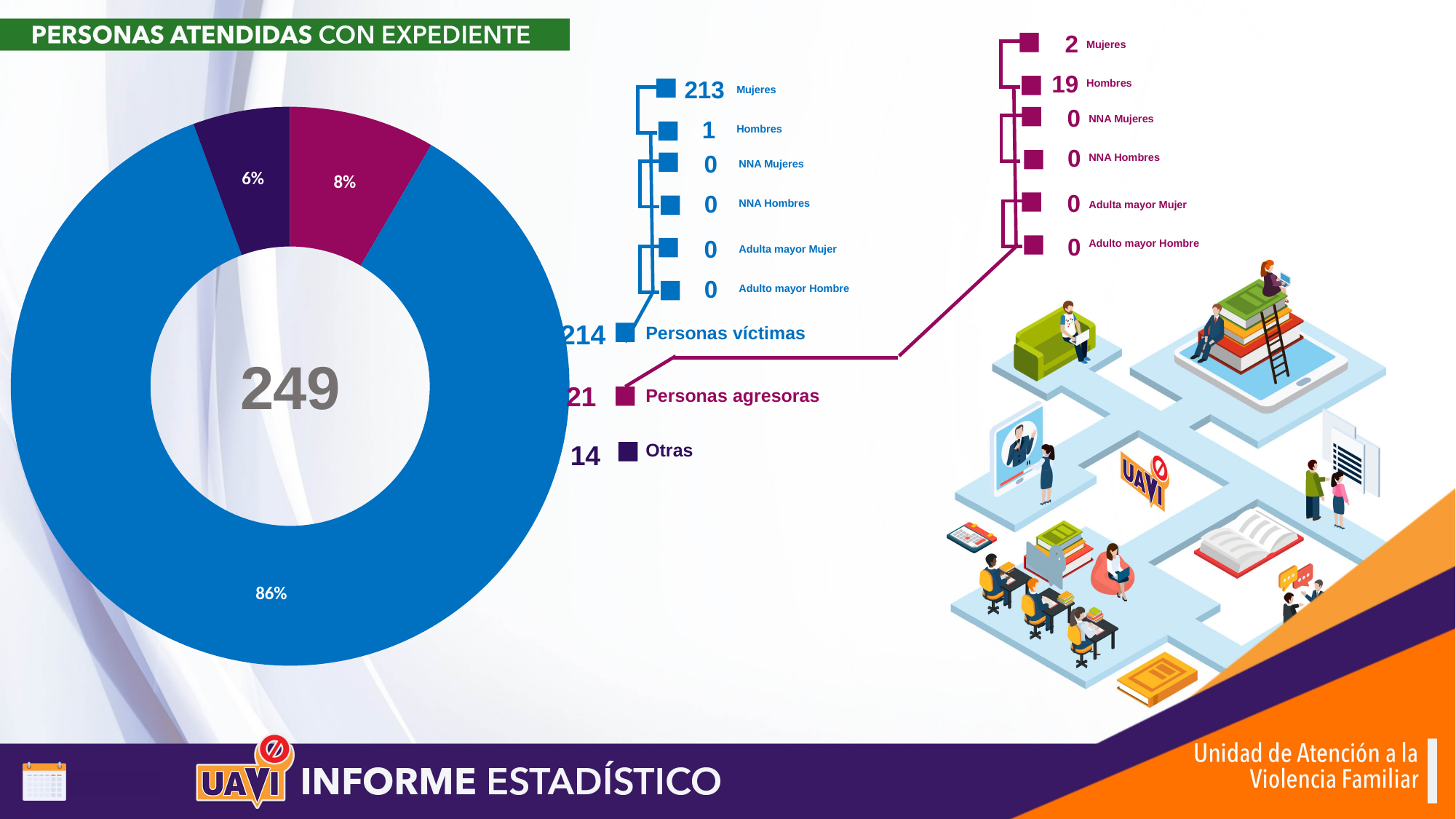
How many slices does the donut chart have? 3 Which category has the largest slice in the donut chart? Personas víctimas What percentage of the donut chart does the Personas agresoras slice represent? 8% What percentage of the donut chart does the Personas víctimas slice represent? 86% What kind of chart is shown on the slide? Donut (pie) chart What is the difference between the number of Personas víctimas and the number of Otras? 200 Which category has the smallest slice in the donut chart? Otras What is the total number shown in the center of the donut chart? 249 What is the number of Personas agresoras shown next to the donut chart? 21 Which is larger, the Personas agresoras slice or the Otras slice? Personas agresoras What colour is the Personas víctimas slice in the donut chart? Blue What percentage of the donut chart does the Otras slice represent? 6%